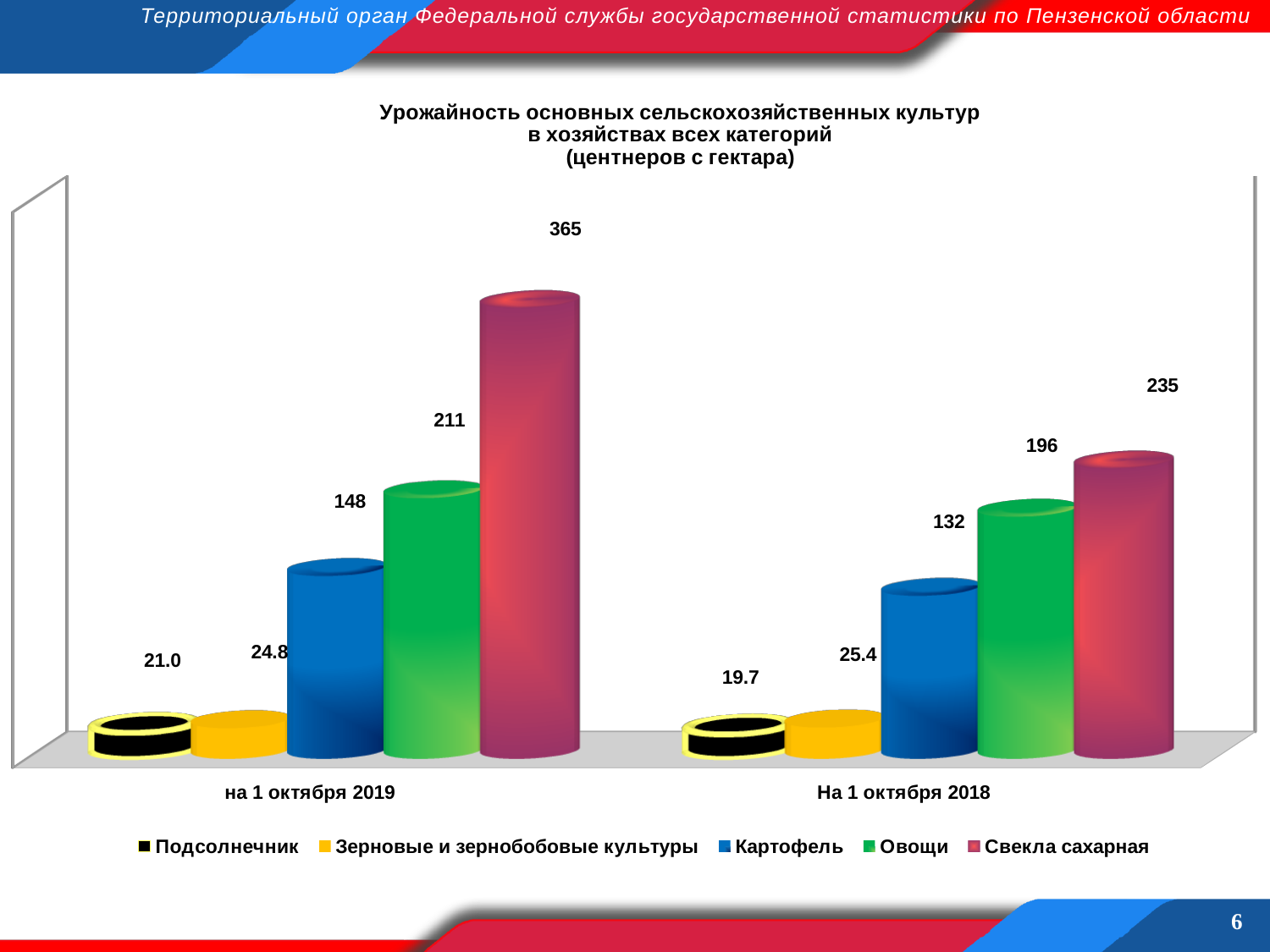
What is the value for Подсолнечник on 1 October 2019? 21.0 Which is larger: Картофель on 1 October 2019 or Картофель on 1 October 2018? Картофель on 1 October 2019 What kind of chart is shown on the slide? Bar chart How many series does the legend list? 5 What is the value for Картофель on 1 October 2018? 132 Which crop has the highest value on 1 October 2018? Свекла сахарная Which crop has the lowest value on 1 October 2019? Подсолнечник How many date categories are shown on the x axis? 2 What is the difference between the Свекла сахарная values on 1 October 2019 and 1 October 2018? 130 What is the value for Зерновые и зернобобовые культуры on 1 October 2018? 25.4 What is the difference between the Овощи values on 1 October 2019 and 1 October 2018? 15 What is the value for Свекла сахарная on 1 October 2019? 365